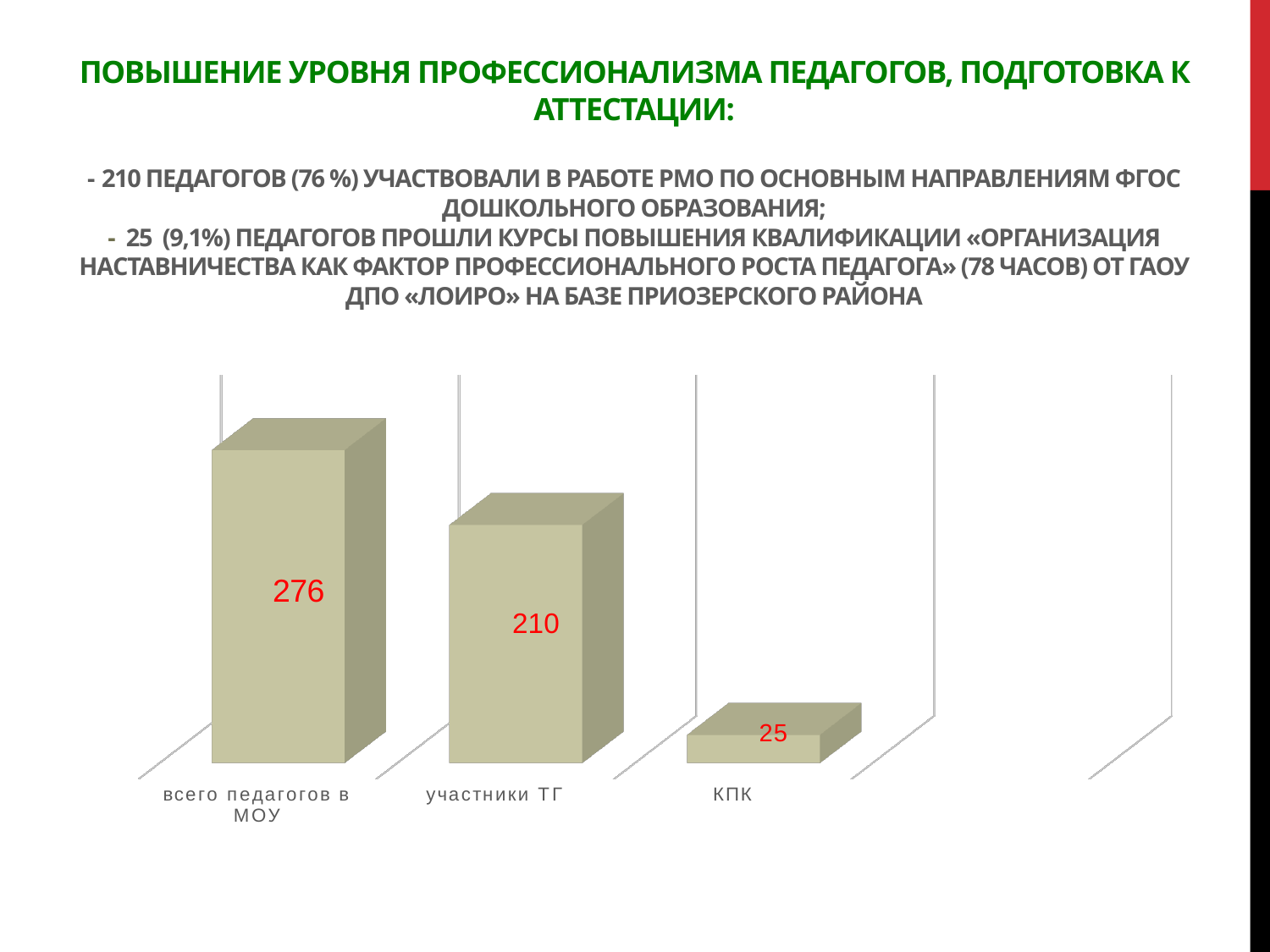
Which category has the lowest value? КПК How many categories are shown in the chart? 3 Which category has the highest value? всего педагогов в МОУ What colour are the data labels on the bars? red Do the values rise or fall from left to right along the x axis? fall Which is larger, the value for "участники ТГ" or the value for "КПК"? участники ТГ What is the value for "всего педагогов в МОУ"? 276 What is the difference between the values for "всего педагогов в МОУ" and "участники ТГ"? 66 What is the value for "КПК"? 25 What kind of chart is shown on the slide? bar chart What is the value for "участники ТГ"? 210 What is the difference between the values for "участники ТГ" and "КПК"? 185